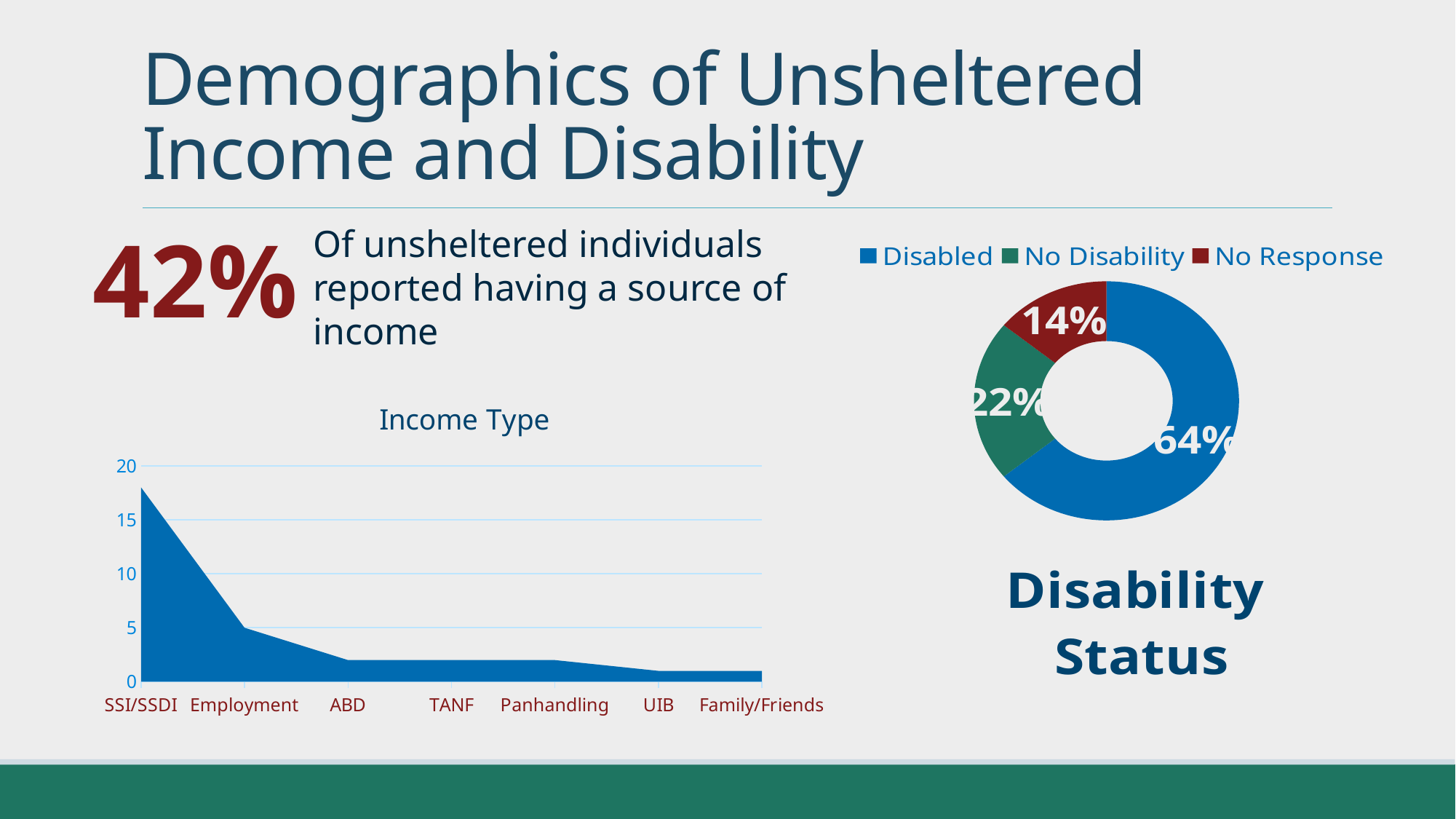
In the Income Type chart, which category has the highest value? SSI/SSDI In the Disability Status chart, what percentage is labelled Disabled? 64% In the Disability Status chart, which category has the smallest share? No Response How many entries does the legend of the Disability Status chart list? 3 What kind of chart is the Disability Status chart? Doughnut chart How many categories are shown on the x axis of the Income Type chart? 7 In the Disability Status chart, what percentage is labelled No Response? 14% In the Disability Status chart, which category has the largest share? Disabled In the Disability Status chart, what percentage is labelled No Disability? 22% In the Income Type chart, is the value for SSI/SSDI greater or less than 15? greater In the Income Type chart, is the value for ABD greater or less than 5? less In the Disability Status chart, how many percentage points larger is Disabled than No Disability? 42